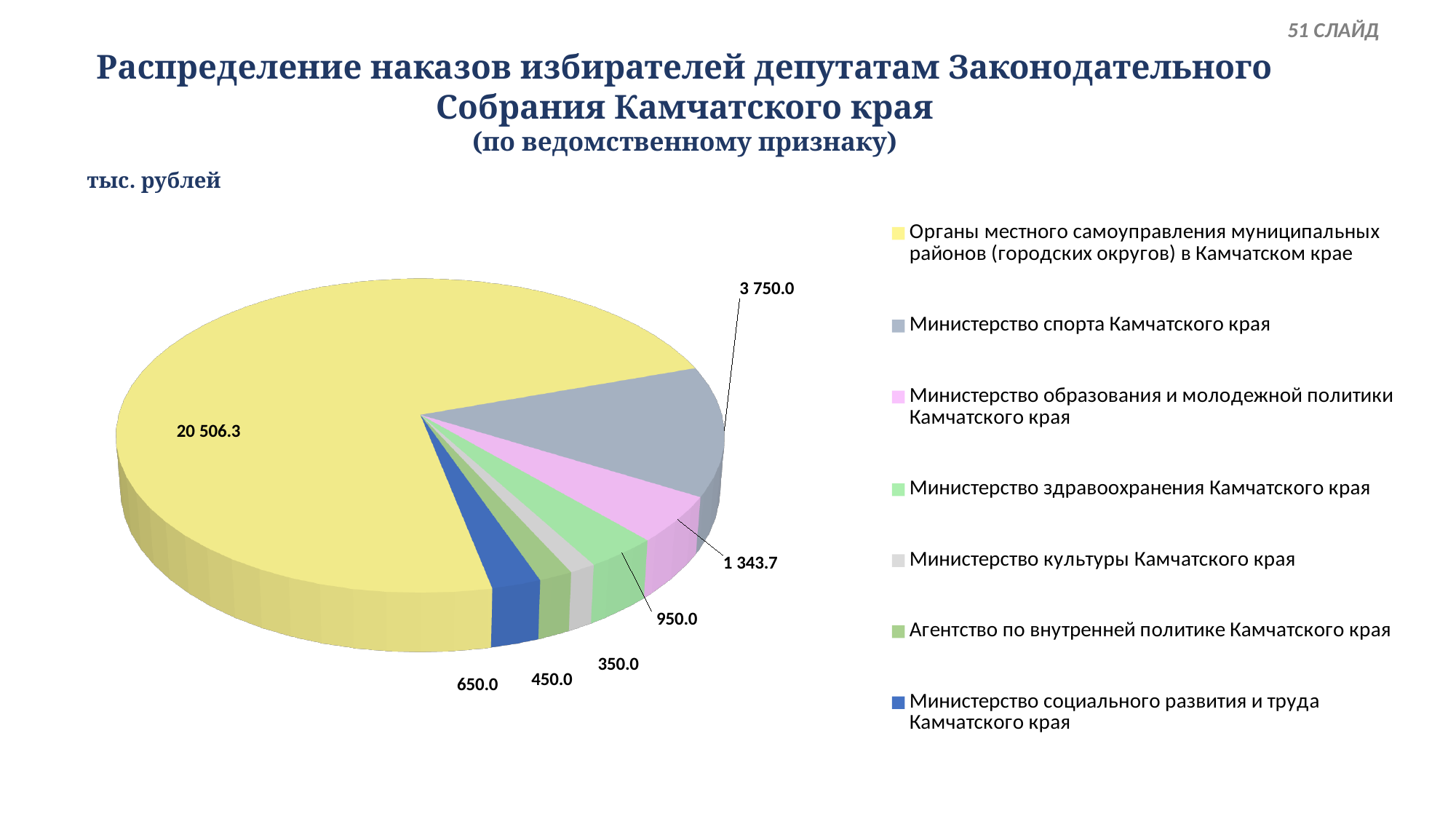
Which category has the smallest slice of the pie? Министерство культуры Камчатского края Which category has the largest slice of the pie? Органы местного самоуправления муниципальных районов (городских округов) в Камчатском крае What value is shown for Министерство здравоохранения Камчатского края? 950.0 How many categories does the pie chart show? 7 What is the difference between the values for Министерство социального развития и труда Камчатского края and Агентство по внутренней политике Камчатского края? 200.0 What kind of chart is shown on the slide? Pie chart Which is larger: the value for Министерство здравоохранения Камчатского края or for Министерство социального развития и труда Камчатского края? Министерство здравоохранения Камчатского края What is the difference between the values for Министерство спорта Камчатского края and Министерство образования и молодежной политики Камчатского края? 2 406.3 What value is shown for Министерство образования и молодежной политики Камчатского края? 1 343.7 What value is shown for Министерство социального развития и труда Камчатского края? 650.0 What value is shown for Министерство спорта Камчатского края? 3 750.0 What value is shown for Министерство культуры Камчатского края? 350.0